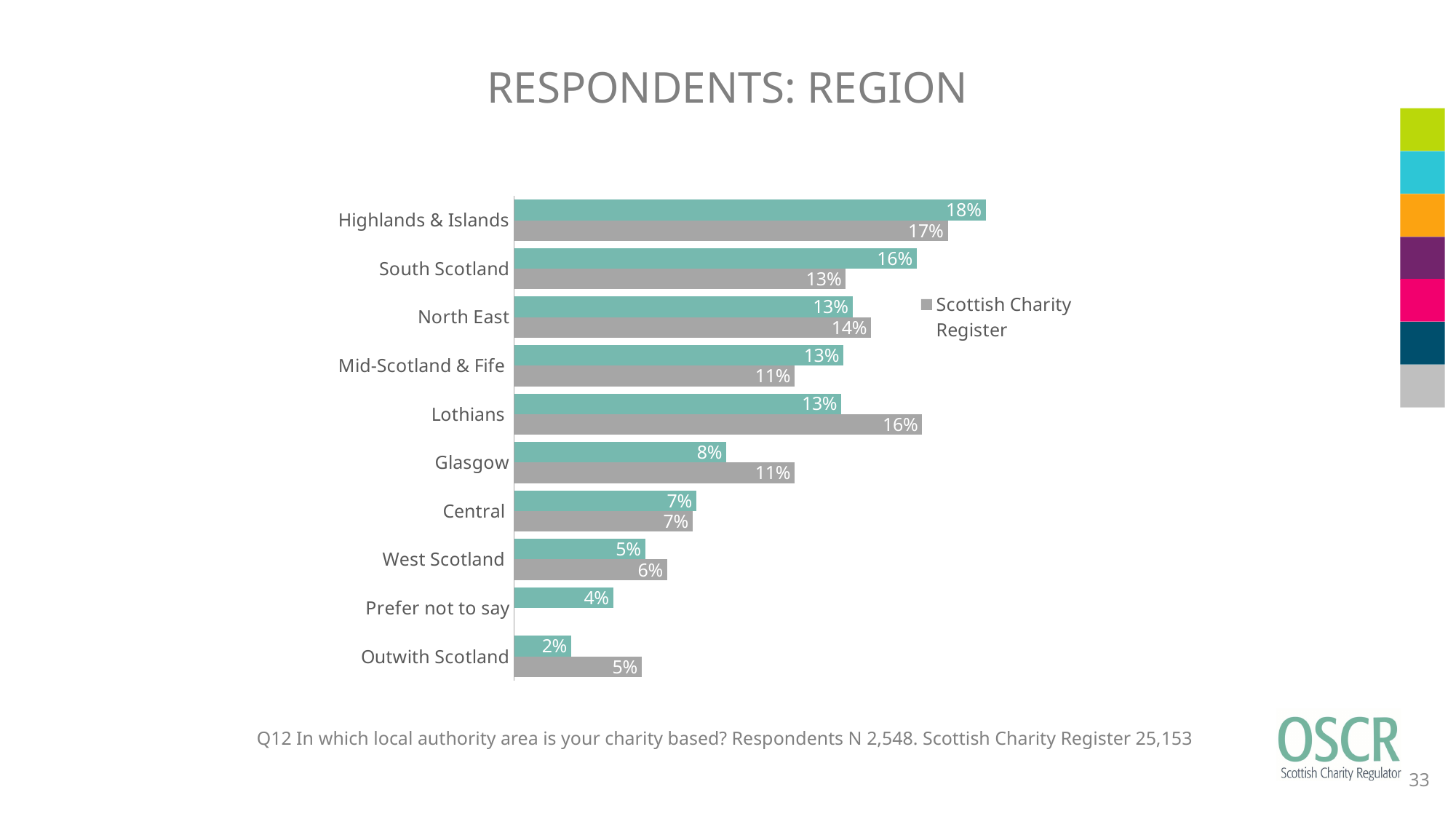
Which category has the highest teal bar value? Highlands & Islands What is the title of the chart on the slide? RESPONDENTS: REGION How many categories are shown on the chart? 10 What is the difference between the teal bar and the Scottish Charity Register bar for Glasgow? 3% Which category has no Scottish Charity Register bar? Prefer not to say For North East, which is larger: the teal bar or the Scottish Charity Register bar? Scottish Charity Register How many series does the legend list? 1 Which category has the lowest teal bar value? Outwith Scotland What kind of chart is shown on the slide? Bar chart What is the value of the teal bar for South Scotland? 16% What is the Scottish Charity Register value for Outwith Scotland? 5% What is the Scottish Charity Register value for Lothians? 16%